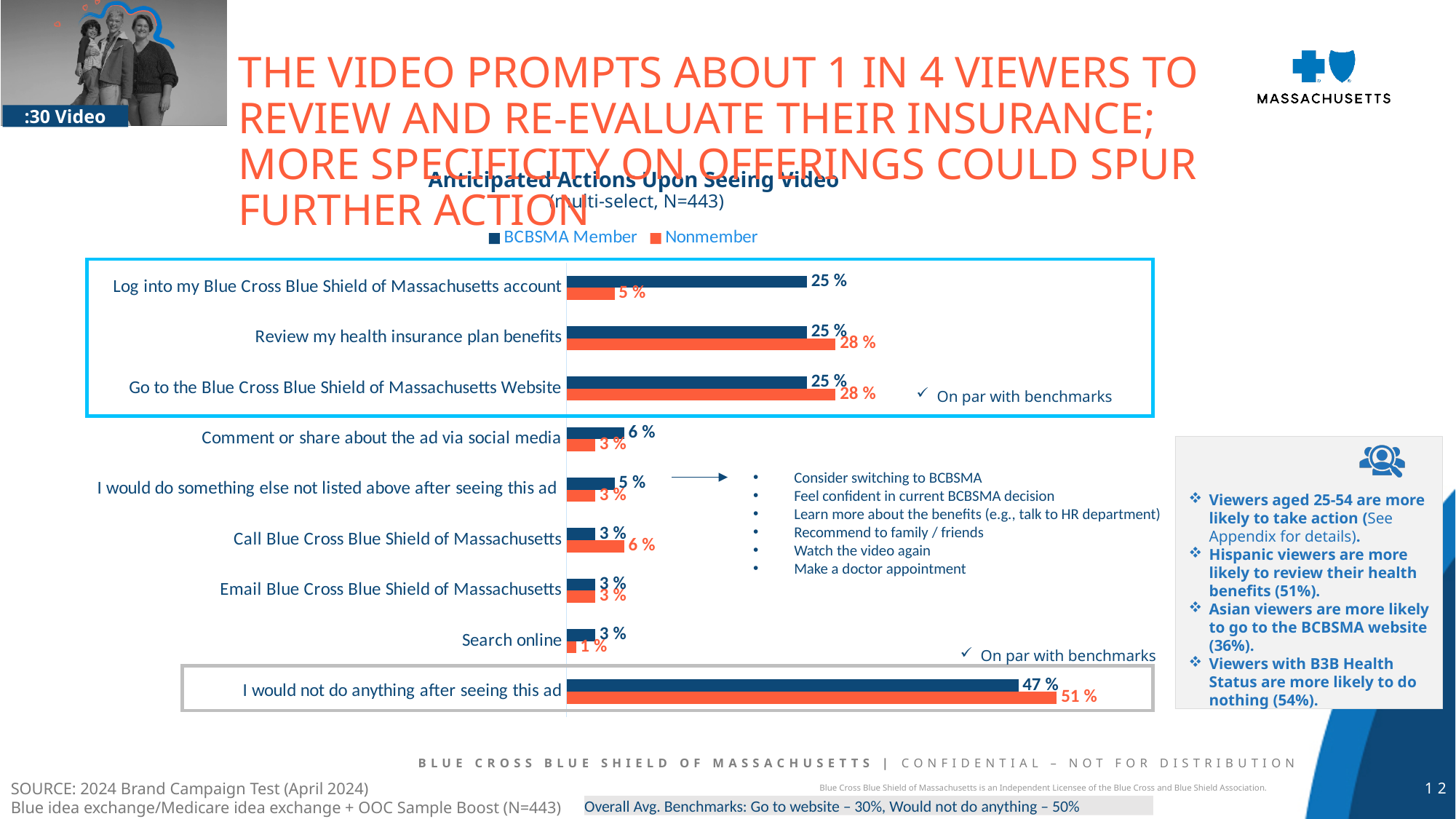
What is the Nonmember value for "Log into my Blue Cross Blue Shield of Massachusetts account"? 5 % What is the difference between the BCBSMA Member and Nonmember values for "Log into my Blue Cross Blue Shield of Massachusetts account"? 20 % What kind of chart is shown on the slide? Bar chart What is the difference between the Nonmember and BCBSMA Member values for "I would not do anything after seeing this ad"? 4 % Which category has the lowest Nonmember value? Search online How many series does the legend list? 2 How many categories are shown in the chart? 9 What is the Nonmember value for "Review my health insurance plan benefits"? 28 % Which category has the highest Nonmember value? I would not do anything after seeing this ad What is the BCBSMA Member value for "I would not do anything after seeing this ad"? 47 % What is the BCBSMA Member value for "Call Blue Cross Blue Shield of Massachusetts"? 3 % For "Call Blue Cross Blue Shield of Massachusetts", which series has the larger value, BCBSMA Member or Nonmember? Nonmember